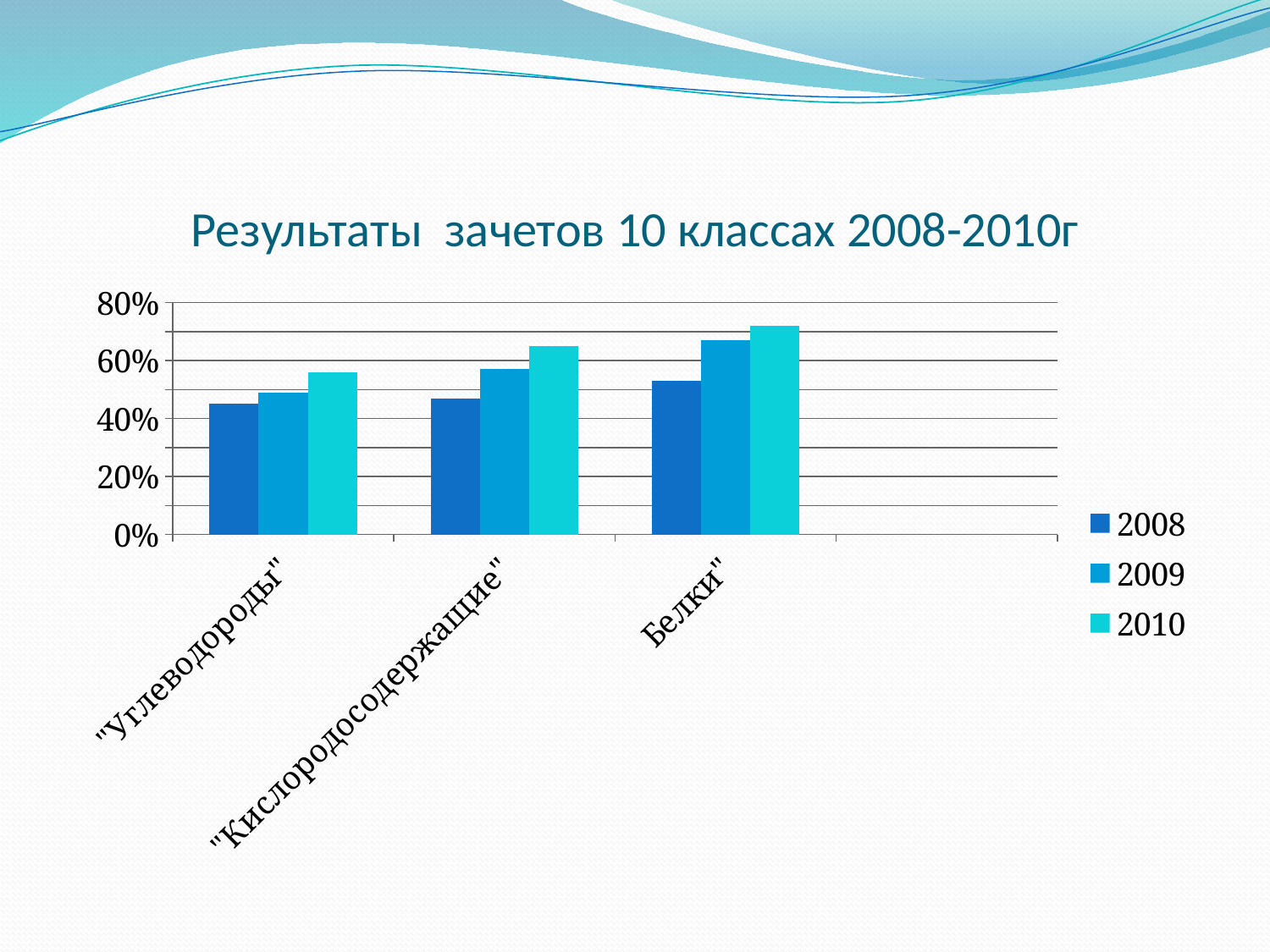
How many categories are shown on the x axis? 3 Is the value for 2008 in "Углеводороды" greater or less than 60%? less Is the value for 2010 in "Белки" greater or less than 60%? greater Which category has the lowest bar for 2008? "Углеводороды" What kind of chart is shown on the slide? bar chart Within each category, do the values rise or fall from 2008 to 2010? rise Is the value for 2008 in "Белки" greater or less than 40%? greater Which is larger: the 2009 value for "Кислородосодержащие" or the 2009 value for "Углеводороды"? "Кислородосодержащие" Which category has the highest bar for 2010? "Белки" What is the title of the chart? Результаты зачетов 10 классах 2008-2010г How many series does the legend list? 3 Which is larger: the 2010 value for "Белки" or the 2010 value for "Углеводороды"? "Белки"